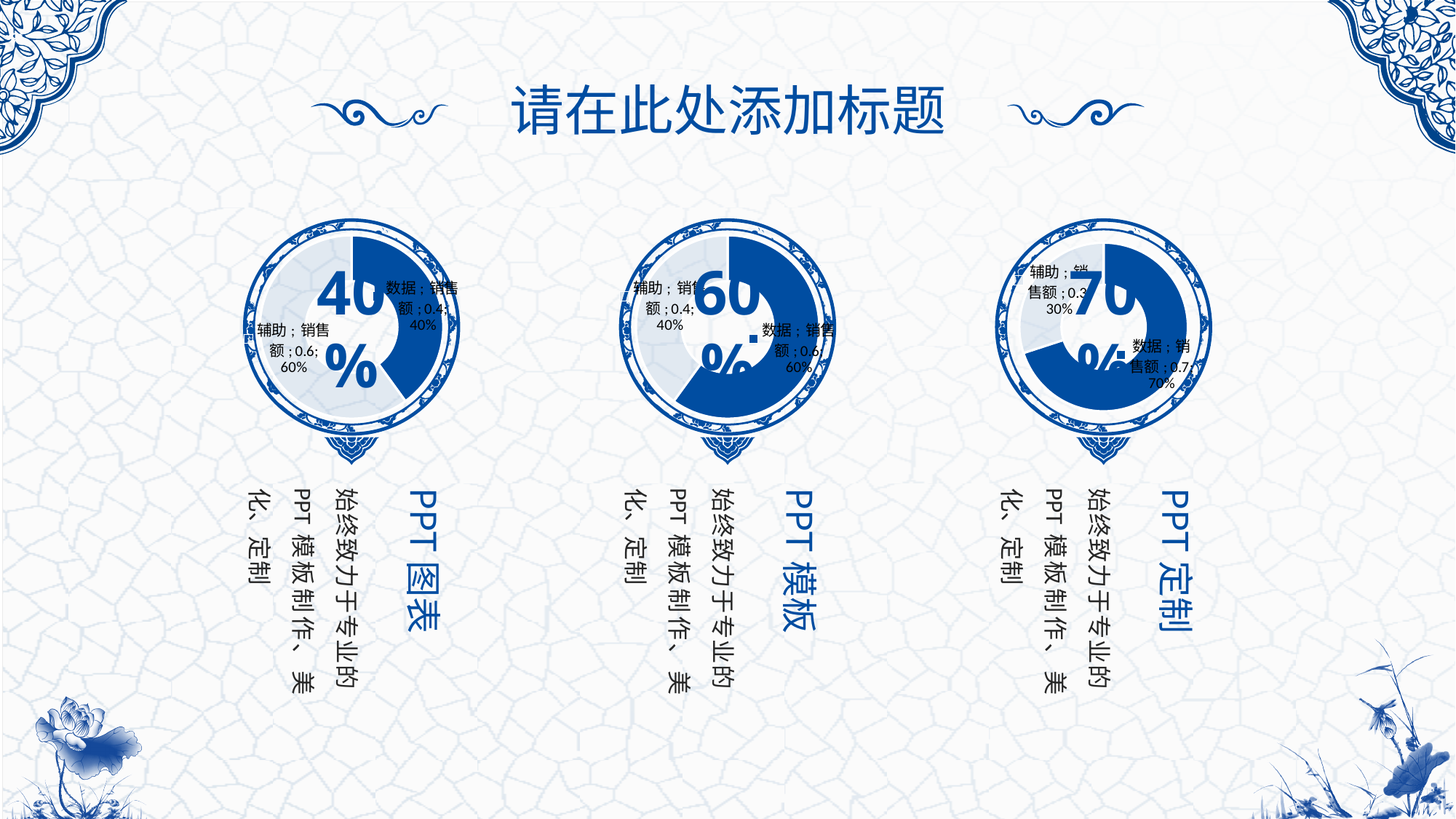
On the left chart (above "PPT 图表"), what percentage is shown for the 辅助 slice? 60% How many charts are shown on the slide? 3 On the right chart (above "PPT 定制"), which slice is the largest? 数据 On the left chart (above "PPT 图表"), what percentage is shown for the 数据 slice? 40% How many slices does the middle chart (above "PPT 模板") have? 2 On the right chart (above "PPT 定制"), which is larger, the 数据 slice or the 辅助 slice? 数据 On the right chart (above "PPT 定制"), what percentage is shown for the 辅助 slice? 30% On the middle chart (above "PPT 模板"), what is the difference in percentage points between the 数据 slice and the 辅助 slice? 20 On the left chart (above "PPT 图表"), which slice is the smallest? 数据 On the middle chart (above "PPT 模板"), what percentage is shown for the 数据 slice? 60% What kind of chart is shown above "PPT 图表"? Doughnut chart On the right chart (above "PPT 定制"), what percentage is shown for the 数据 slice? 70%